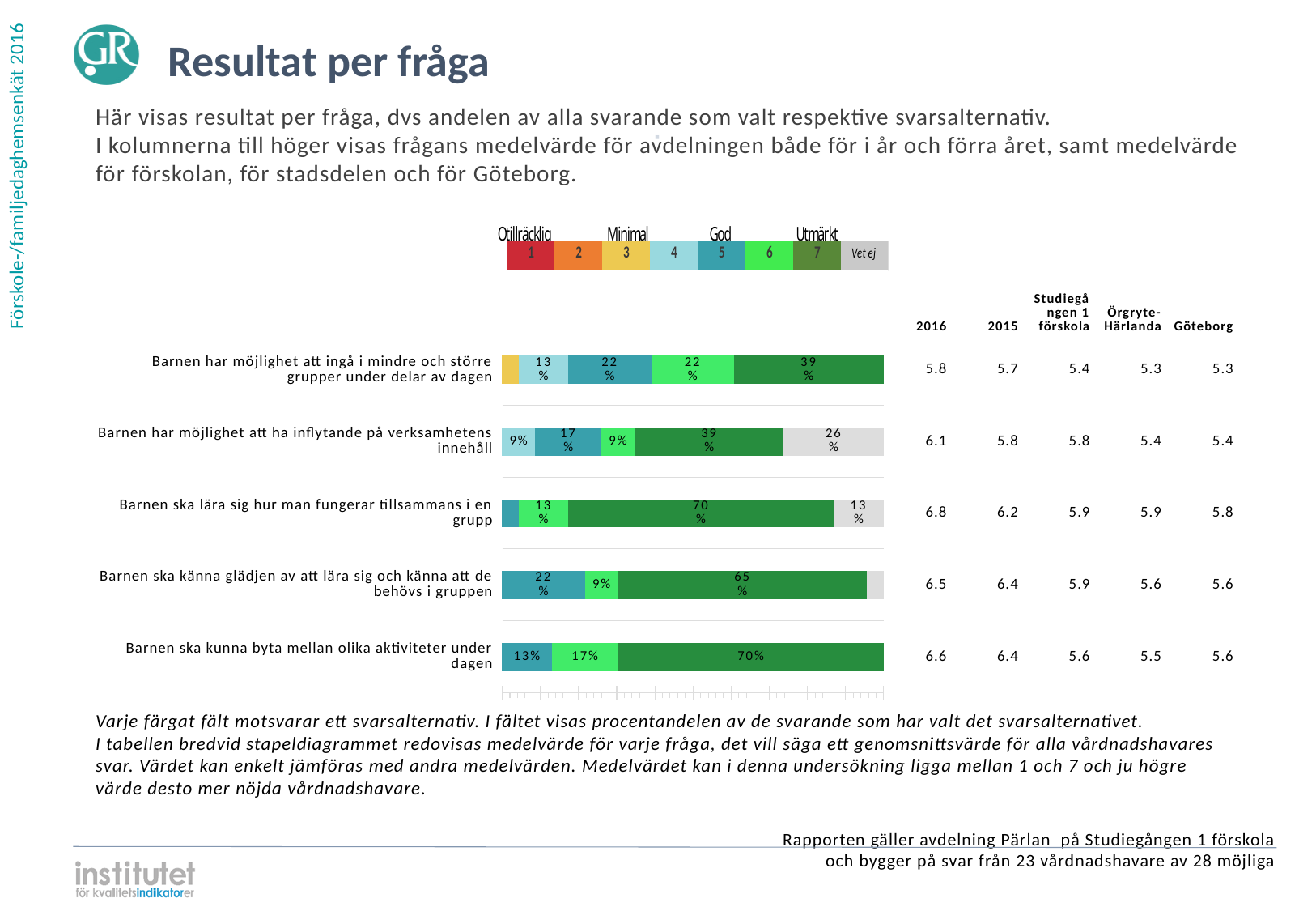
What is the total of the labelled segments for 'Barnen ska kunna byta mellan olika aktiviteter under dagen'? 100% What percentage chose 4 for 'Barnen har möjlighet att ingå i mindre och större grupper under delar av dagen'? 13% What percentage chose 7 (Utmärkt) for 'Barnen ska känna glädjen av att lära sig och känna att de behövs i gruppen'? 65% What is the 2016 mean value shown for 'Barnen ska lära sig hur man fungerar tillsammans i en grupp'? 6.8 How many questions (categories) are plotted in the bar chart? 5 Which is larger: the 5 (God) share for 'Barnen ska känna glädjen av att lära sig och känna att de behövs i gruppen' or for 'Barnen ska kunna byta mellan olika aktiviteter under dagen'? Barnen ska känna glädjen av att lära sig och känna att de behövs i gruppen What percentage of respondents chose 7 (Utmärkt) for 'Barnen ska kunna byta mellan olika aktiviteter under dagen'? 70% What percentage chose 'Vet ej' for 'Barnen har möjlighet att ha inflytande på verksamhetens innehåll'? 26% What is the difference between the 7 (Utmärkt) share for 'Barnen ska lära sig hur man fungerar tillsammans i en grupp' and for 'Barnen har möjlighet att ha inflytande på verksamhetens innehåll'? 31 percentage points How many answer alternatives does the legend above the chart list? 8 What kind of chart is shown on the slide? Stacked bar chart